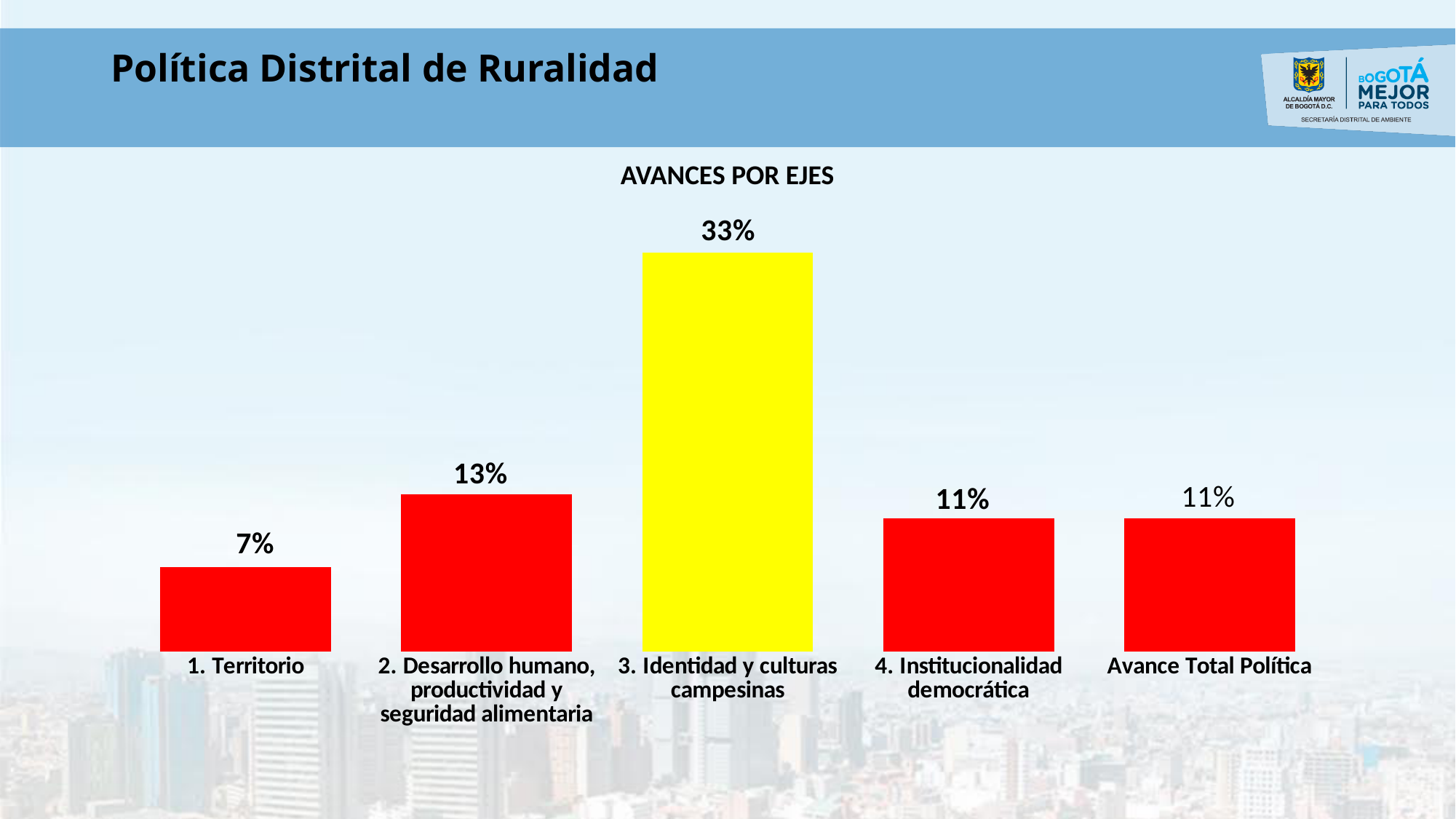
How many bars are shown in the chart? 5 What is the value for 3. Identidad y culturas campesinas? 33% Which is larger, the value for 2. Desarrollo humano, productividad y seguridad alimentaria or the value for 1. Territorio? 2. Desarrollo humano, productividad y seguridad alimentaria What is the difference between the values for 3. Identidad y culturas campesinas and 1. Territorio? 26% What is the title of the chart? AVANCES POR EJES What is the value for Avance Total Política? 11% What is the difference between the values for 2. Desarrollo humano, productividad y seguridad alimentaria and 4. Institucionalidad democrática? 2% What is the value for 2. Desarrollo humano, productividad y seguridad alimentaria? 13% Which category has the highest value? 3. Identidad y culturas campesinas Which category has the lowest value? 1. Territorio What is the value for 1. Territorio? 7% What kind of chart is shown on the slide? Bar chart